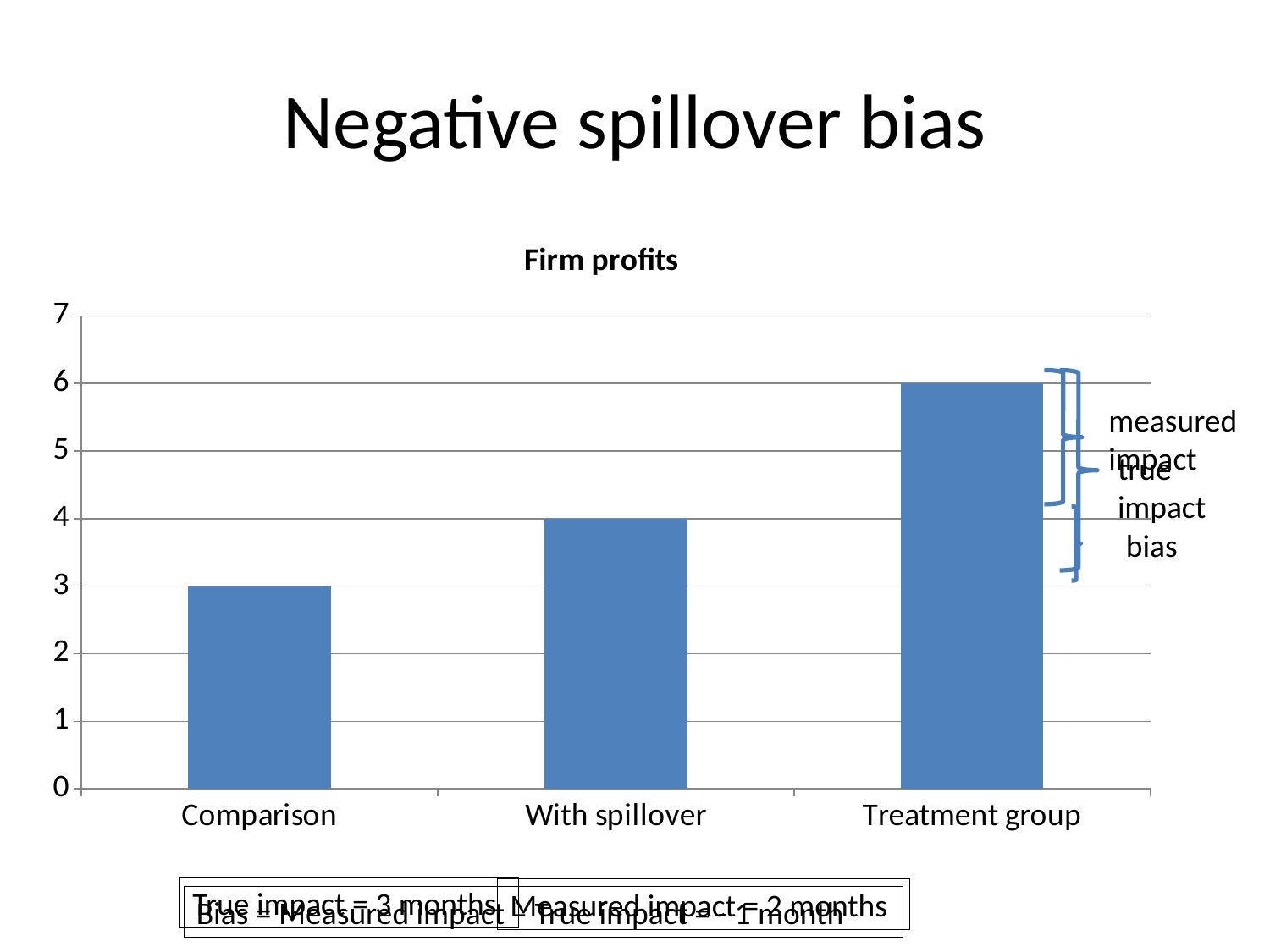
What kind of chart is shown on the slide? bar chart What is the title of the chart? Firm profits How many categories are shown on the x axis of the chart? 3 Which category has the highest value in the Firm profits chart? Treatment group What is the value for Treatment group in the Firm profits chart? 6 What is the difference between the Treatment group and Comparison values? 3 Which category has the lowest value in the Firm profits chart? Comparison What is the value for Comparison in the Firm profits chart? 3 What is the value for With spillover in the Firm profits chart? 4 What is the difference between the Treatment group and With spillover values? 2 Which is larger, the value for With spillover or the value for Comparison? With spillover Is the value for Treatment group greater or less than 5? greater